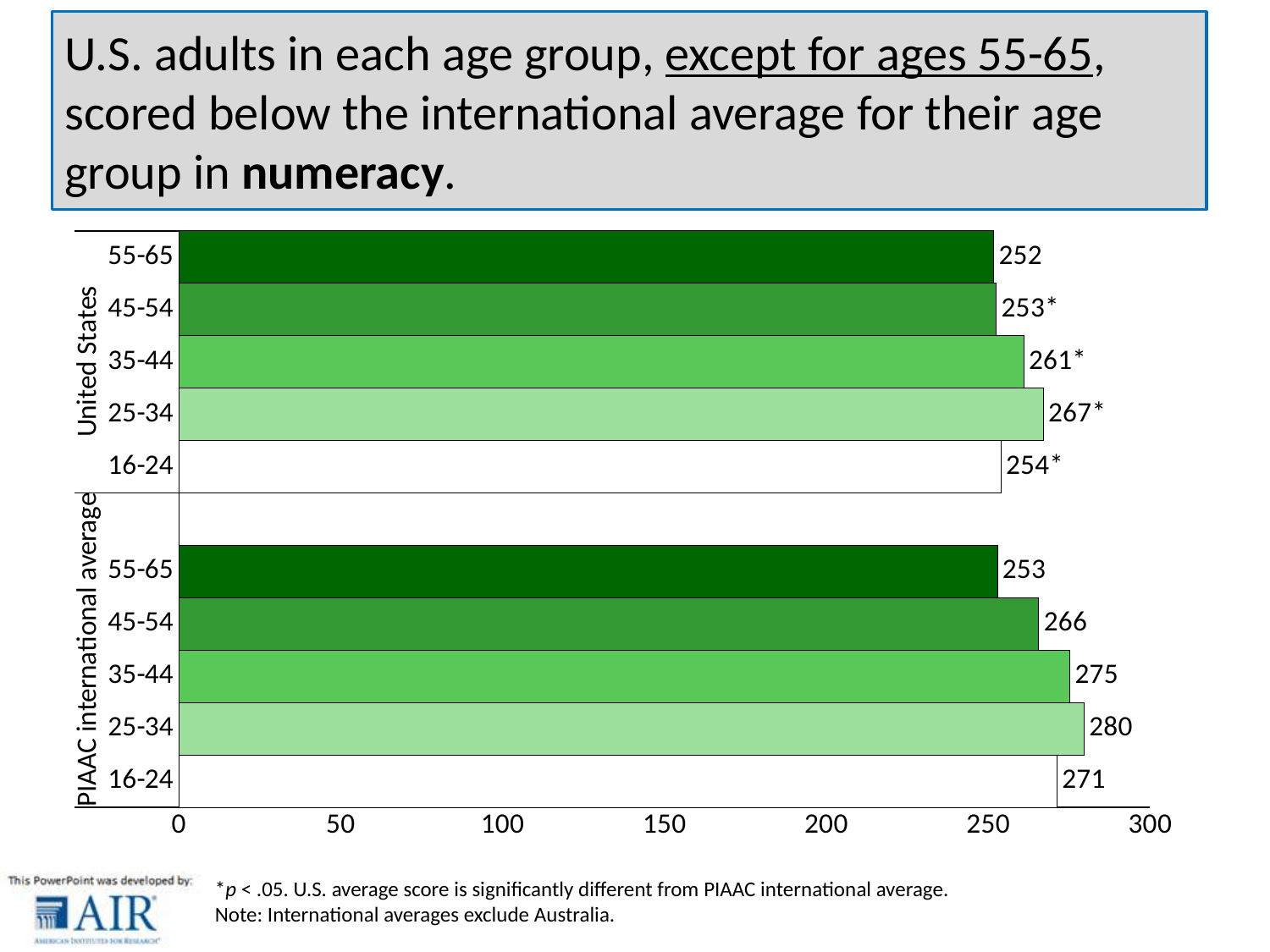
Which age group has the highest PIAAC international average numeracy score? 25-34 What kind of chart is shown on the slide? Bar chart Which is larger: the U.S. score for ages 16-24 or the PIAAC international average for ages 16-24? PIAAC international average What is the numeracy score for U.S. adults ages 25-34? 267* What is the PIAAC international average numeracy score for ages 35-44? 275 What is the numeracy score for U.S. adults ages 55-65? 252 How many bars are plotted in the chart? 10 What is the difference between the PIAAC international average scores for ages 35-44 and ages 55-65? 22 Which age group has the lowest United States numeracy score? 55-65 What is the difference between the PIAAC international average and the U.S. score for ages 25-34? 13 What is the maximum value shown on the horizontal axis? 300 What is the PIAAC international average numeracy score for ages 16-24? 271